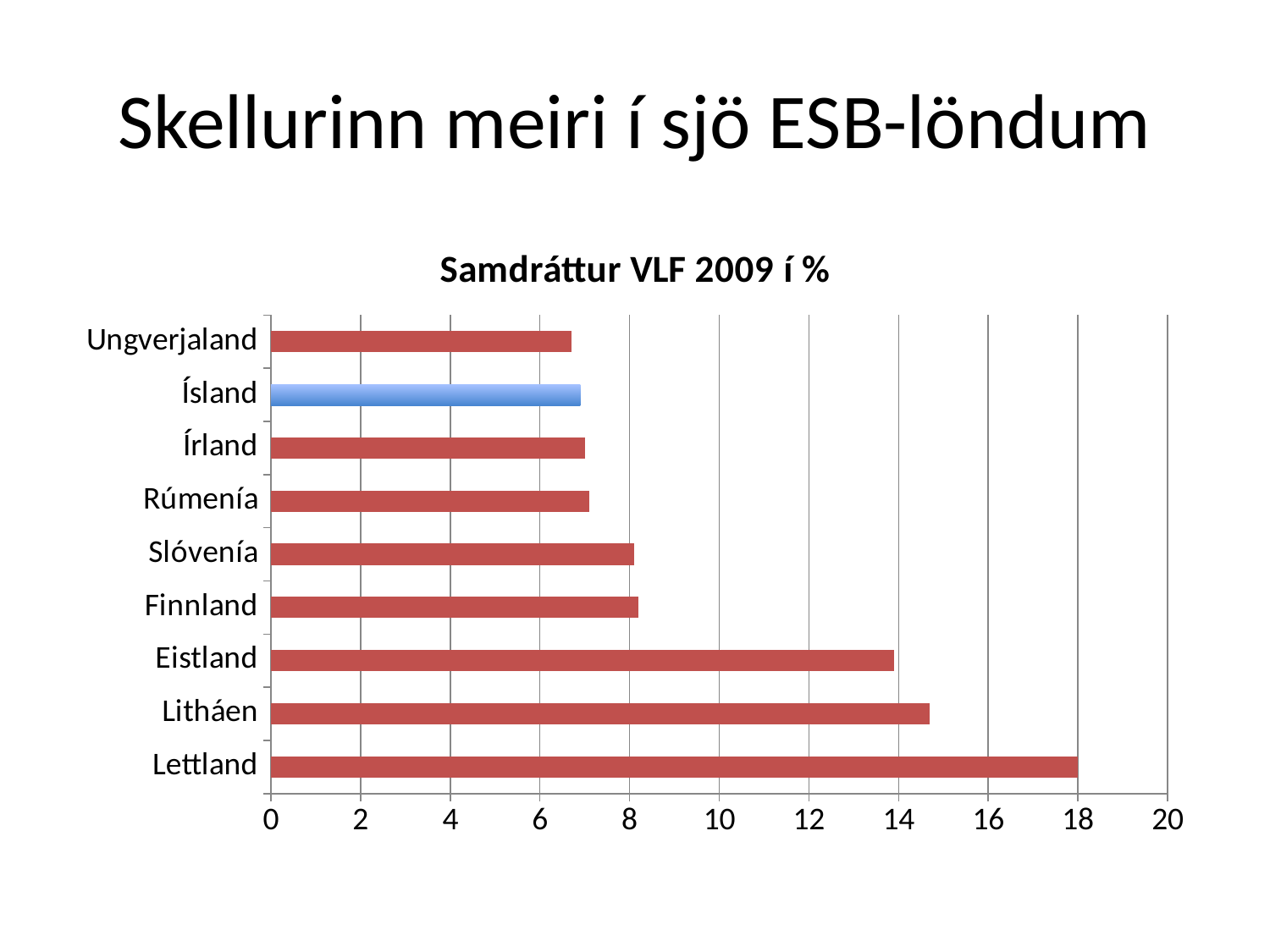
What is the value for Lettland? 18 How many countries are shown in the chart? 9 What kind of chart is shown on the slide? bar chart Which country's bar is coloured differently (blue) from the others? Ísland Which has the larger value, Litháen or Eistland? Litháen What is the title of the chart? Samdráttur VLF 2009 í % Which has the larger value, Finnland or Eistland? Eistland Is the value for Ungverjaland greater or less than 8? less Is the value for Litháen greater or less than 14? greater Which country has the highest value in the chart? Lettland